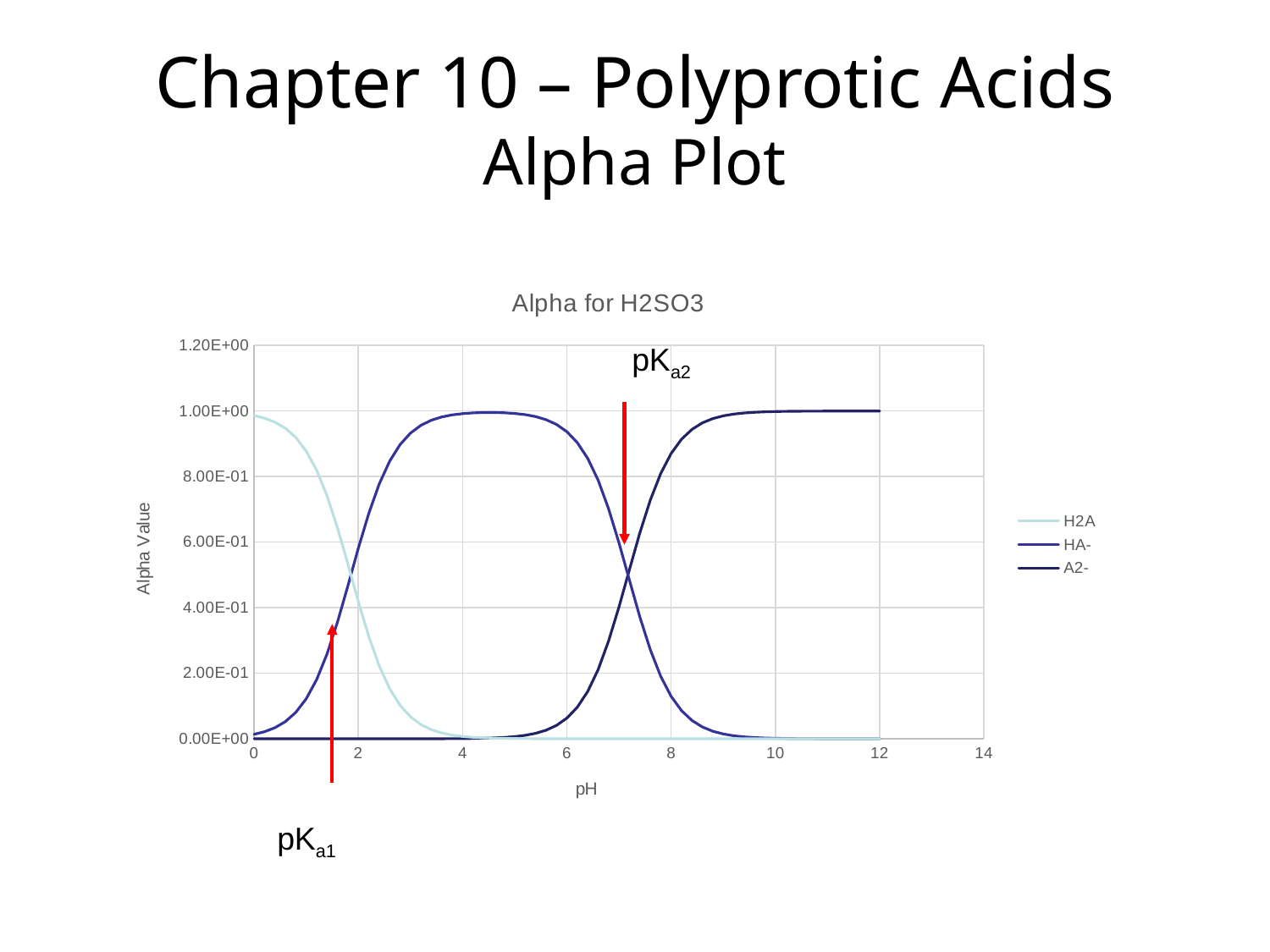
What is the title of the chart? Alpha for H2SO3 How many series does the legend of the chart list? 3 What kind of chart is shown on the slide? line chart Is the value of the HA- series at pH 4 greater or less than 8.00E-01? greater Which series has the highest value at pH 4? HA- Does the A2- series rise or fall as pH increases? rise Is the value of the A2- series at pH 2 greater or less than 2.00E-01? less Is the value of the HA- series at pH 10 greater or less than 2.00E-01? less Does the H2A series rise or fall as pH increases? fall What is the label of the x axis of the chart? pH At pH 10, which series has the larger value, A2- or HA-? A2-